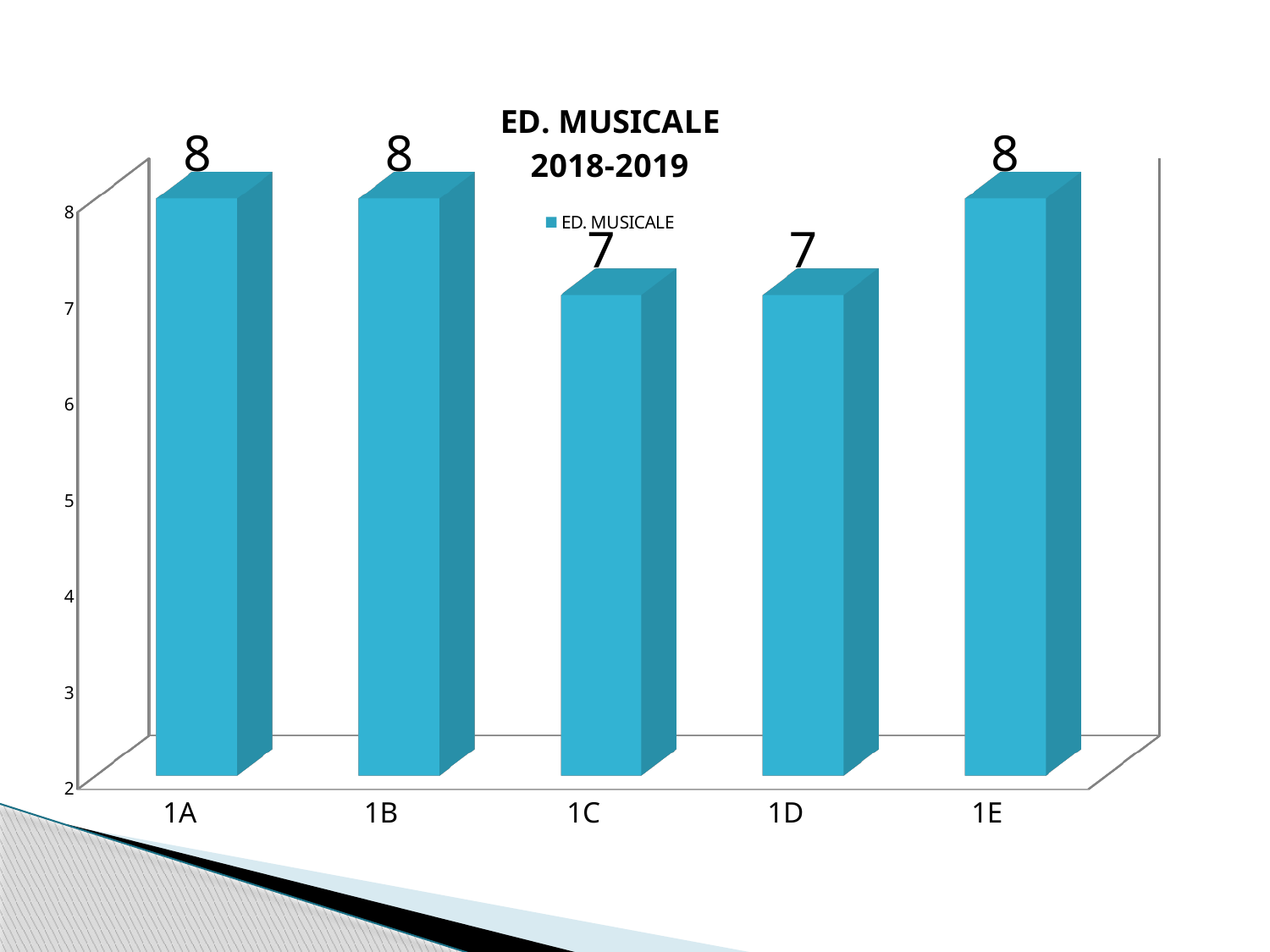
What is the value for 1A? 8 Which category has the lowest value, 1B or 1C? 1C Is the value for 1C greater or less than 1A? less What is the value for 1D? 7 What is the value for 1E? 8 How many categories are shown on the x axis? 5 What is the series name shown in the legend? ED. MUSICALE What is the title of the chart? ED. MUSICALE 2018-2019 What kind of chart is shown? bar chart How many series does the legend list? 1 What is the value for 1C? 7 What is the difference between the values for 1B and 1D? 1